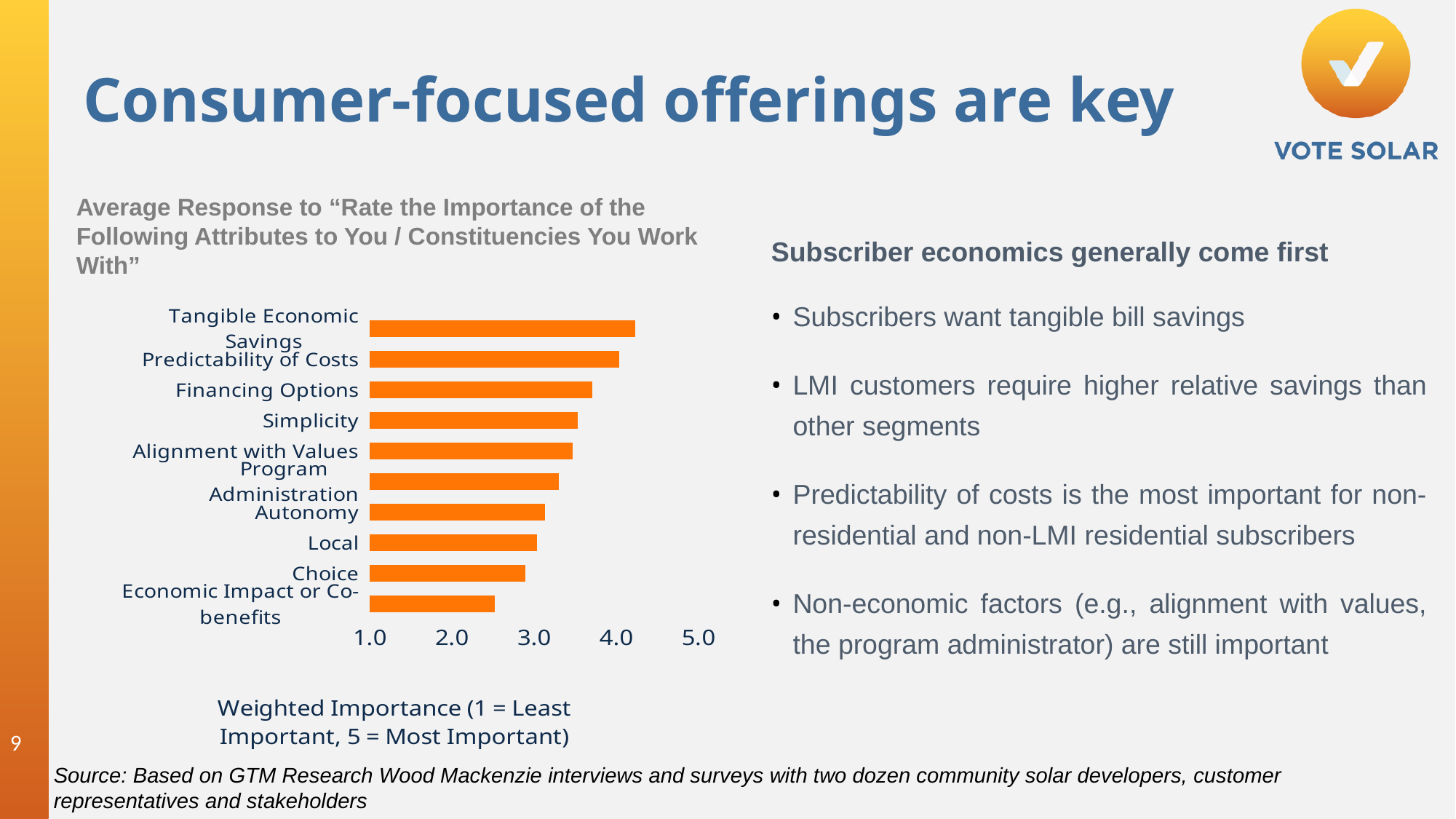
Is the value for Tangible Economic Savings greater or less than 4.0? greater What is the label on the horizontal axis of the chart? Weighted Importance (1 = Least Important, 5 = Most Important) Do the bar lengths increase or decrease going from the top category to the bottom category? decrease Which has a higher weighted importance, Financing Options or Choice? Financing Options How many attributes (categories) are plotted in the bar chart? 10 Is the value for Economic Impact or Co-benefits greater or less than 2.0? greater Is the value for Economic Impact or Co-benefits greater or less than 3.0? less Which attribute has the highest weighted importance in the chart? Tangible Economic Savings What kind of chart is shown on the slide? bar chart Which attribute has the lowest weighted importance in the chart? Economic Impact or Co-benefits